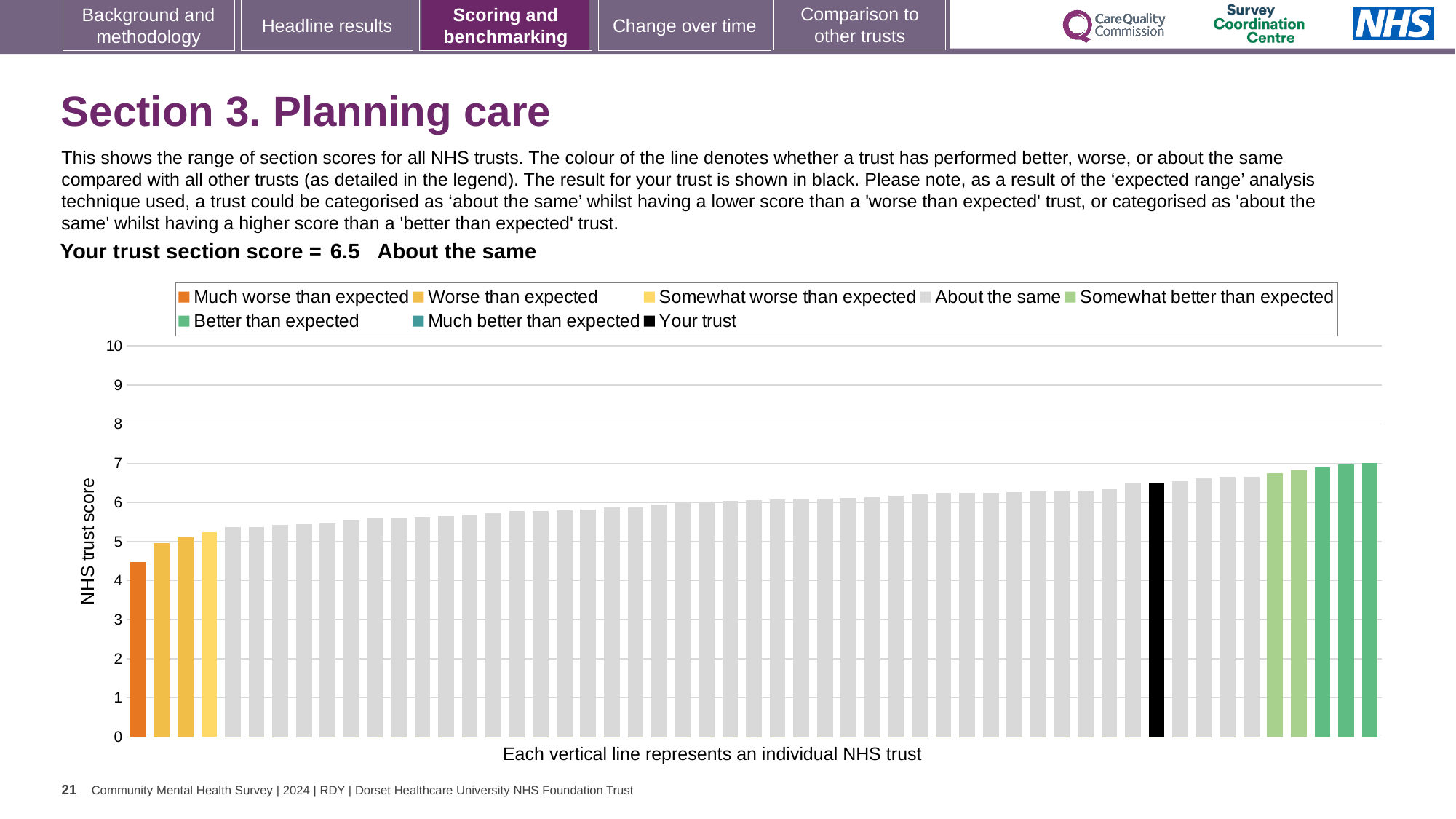
How many bars are coloured as 'Much worse than expected'? 1 Which legend category do the highest bars on the chart belong to? Better than expected What is the label on the vertical axis of the chart? NHS trust score Is the value of the lowest bar (the orange 'Much worse than expected' trust) greater or less than 5? less Do the bar values rise or fall moving from left to right along the x axis? rise What type of chart is shown on the slide? bar chart What is the section score for your trust? 6.5 Is the value for your trust (the black bar) greater or less than 6? greater Which benchmarking category is your trust placed in for this section? About the same How many entries does the chart legend list? 8 Is the value for your trust (the black bar) greater or less than 7? less